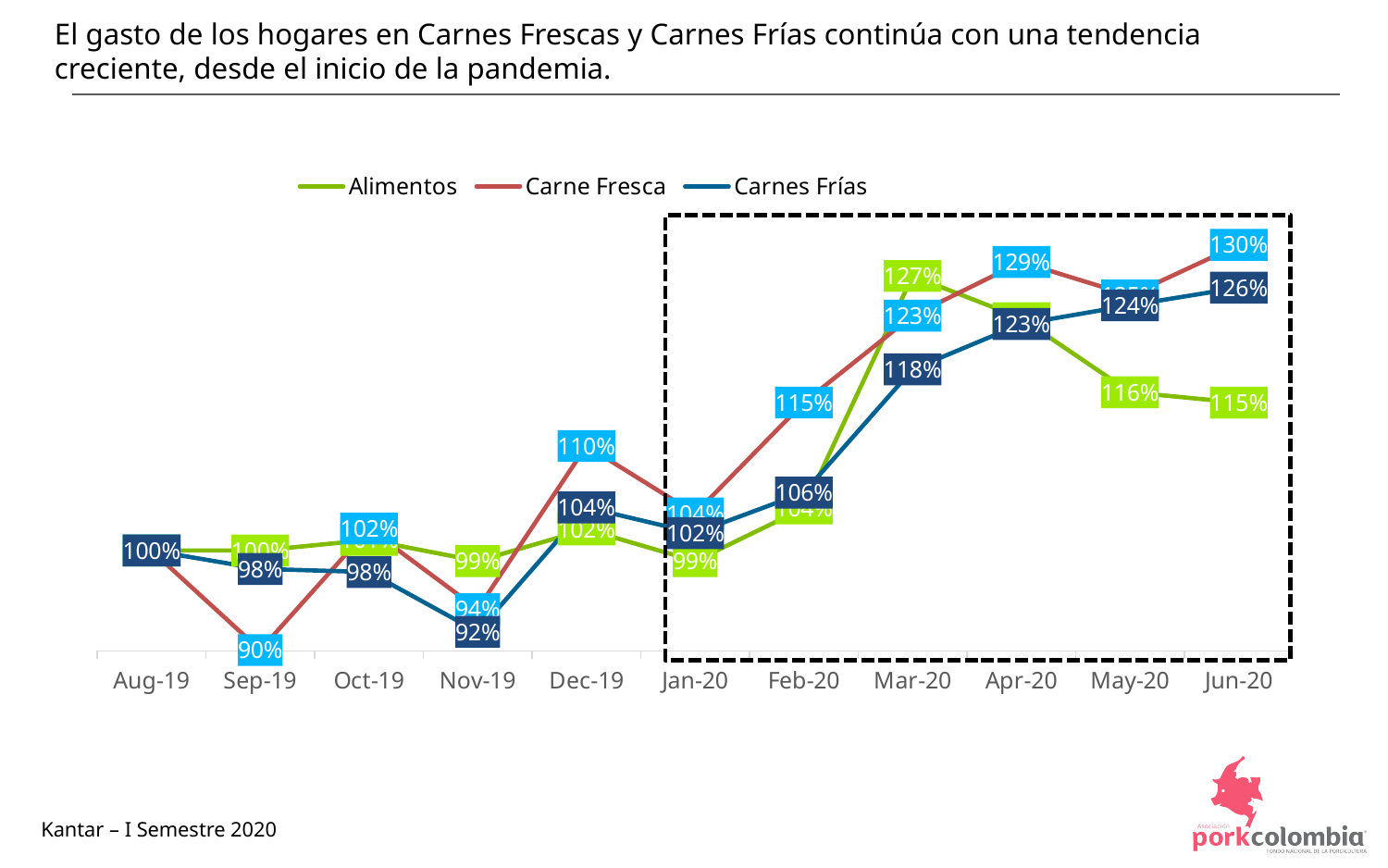
In which month is the Carne Fresca value highest? Jun-20 What is the value for Carne Fresca in Jun-20? 130% How many series does the legend list? 3 What is the difference between Carne Fresca and Carnes Frías in Jun-20? 4 percentage points How many months are shown on the x axis? 11 What is the value for Carne Fresca in Sep-19? 90% What is the value for Carnes Frías in Nov-19? 92% What type of chart is shown on the slide? line chart What is the value for Carnes Frías in Jun-20? 126% In which month is the Carne Fresca value lowest? Sep-19 Which is larger in Jun-20, Carne Fresca or Alimentos? Carne Fresca What is the value for Alimentos in Mar-20? 127%